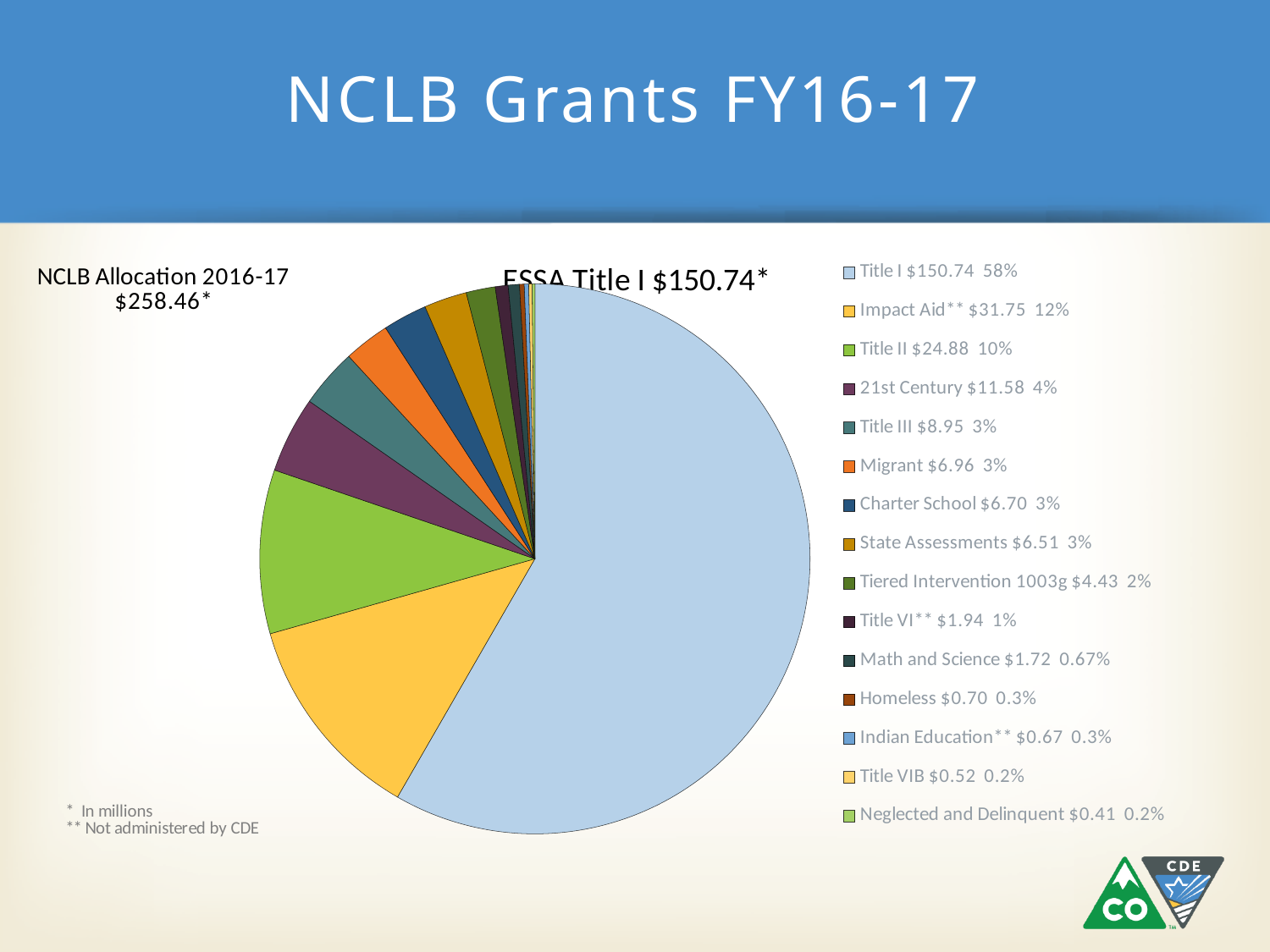
What is the value shown for Title II? $24.88 What is the total NCLB Allocation 2016-17 shown on the slide? $258.46 Which is larger, the value for 21st Century or the value for Title III? 21st Century Which category has the largest slice of the pie chart? Title I What is the difference between the Title I value and the Impact Aid** value? $118.99 What percentage share does Math and Science have? 0.67% What is the value shown for Title I in the legend? $150.74 Which category has the smallest value in the legend? Neglected and Delinquent What is the title of the slide containing the pie chart? NCLB Grants FY16-17 What percentage share does Impact Aid** have in the pie chart? 12% How many categories are listed in the pie chart legend? 15 What type of chart is shown on the slide? Pie chart